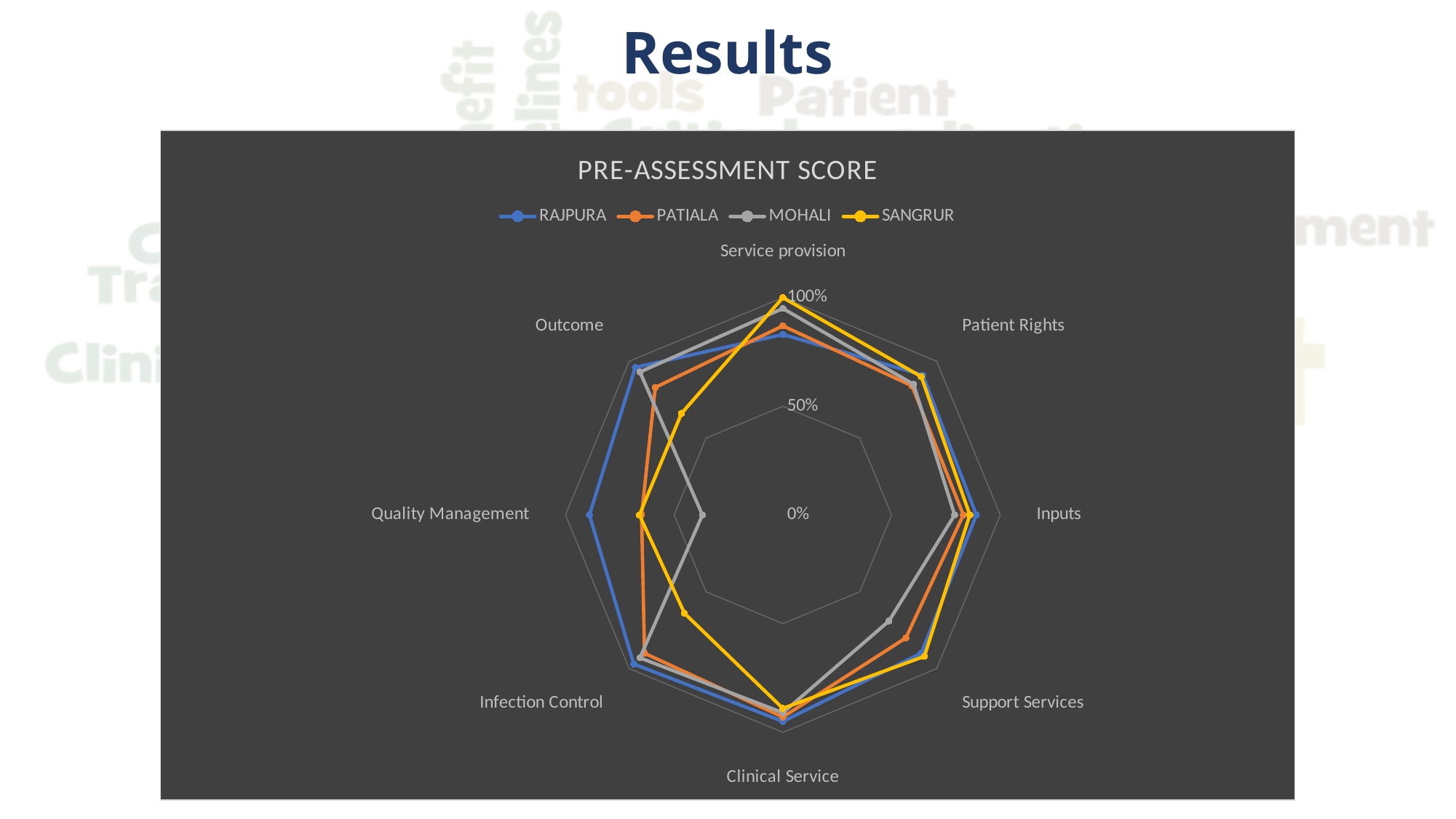
What kind of chart is shown on the slide? Radar chart Is the value for MOHALI on Quality Management greater or less than 50%? less How many categories (axes) does the radar chart have? 8 Which series has the lowest value for Support Services? MOHALI Which series has the lowest value for Infection Control? SANGRUR Which series is shown in yellow in the legend? SANGRUR Is the value for SANGRUR on Infection Control greater or less than 50%? greater Which series has the lowest value for Quality Management? MOHALI What is the title of the chart? PRE-ASSESSMENT SCORE How many series does the legend list? 4 Which series has the highest value for Quality Management? RAJPURA